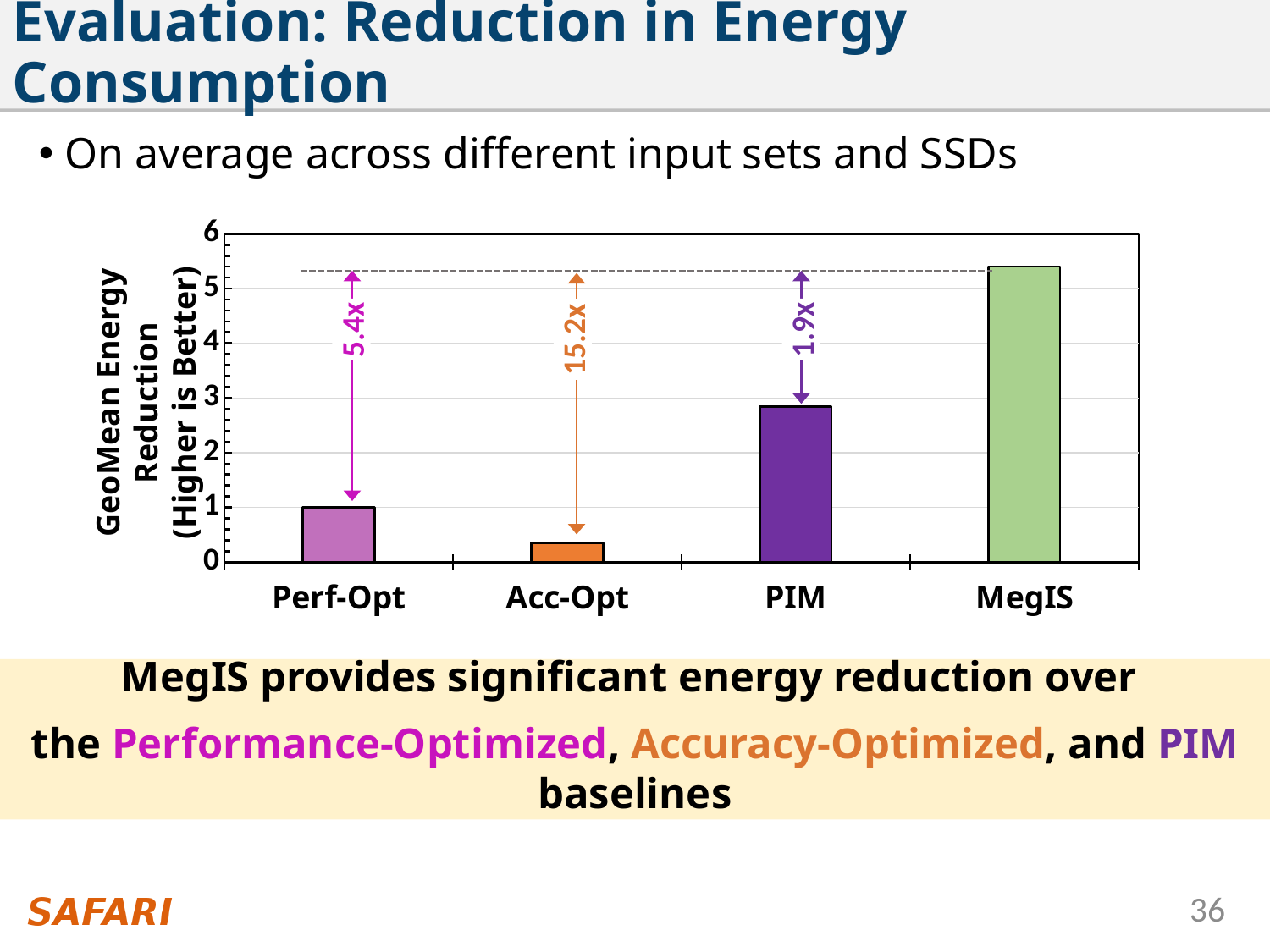
What is the GeoMean Energy Reduction value for Perf-Opt? 1 Is the value for PIM greater or less than 2? greater How many categories are shown on the x axis of the chart? 4 What is the label of the y axis of the chart? GeoMean Energy Reduction (Higher is Better) Which has a larger GeoMean Energy Reduction, PIM or Perf-Opt? PIM Is the value for MegIS greater or less than 5? greater According to the annotation on the chart, by what factor does MegIS improve over Acc-Opt? 15.2x Is the value for Acc-Opt greater or less than 1? less Which category has the lowest GeoMean Energy Reduction? Acc-Opt Which category has the highest GeoMean Energy Reduction? MegIS What kind of chart is shown on the slide? bar chart Which has a larger GeoMean Energy Reduction, Perf-Opt or Acc-Opt? Perf-Opt